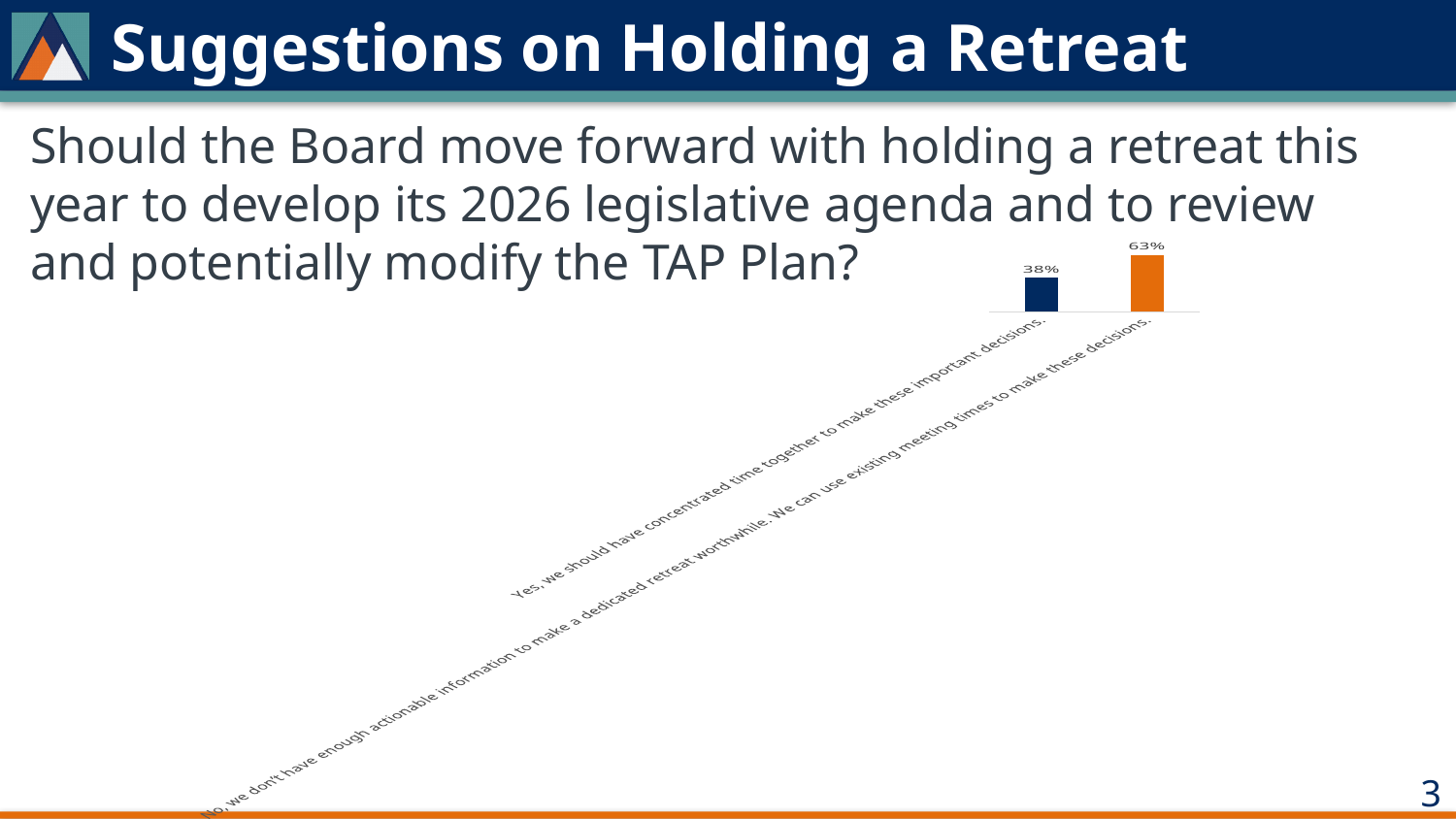
How many bars are shown in the chart? 2 What colour is the bar for the "No" response? Orange Which response option has the highest value? No, we don't have enough actionable information to make a dedicated retreat worthwhile. We can use existing meeting times to make these decisions. What kind of chart is shown on the slide? Bar chart What is the value for the "No, we don't have enough actionable information to make a dedicated retreat worthwhile. We can use existing meeting times to make these decisions." bar? 63% Which is larger: the value for the "Yes" response or the value for the "No" response? No What colour is the bar for the "Yes" response? Blue Which response option has the lowest value? Yes, we should have concentrated time together to make these important decisions. What is the value for the "Yes, we should have concentrated time together to make these important decisions." bar? 38% What is the difference in percentage points between the "No" response and the "Yes" response? 25